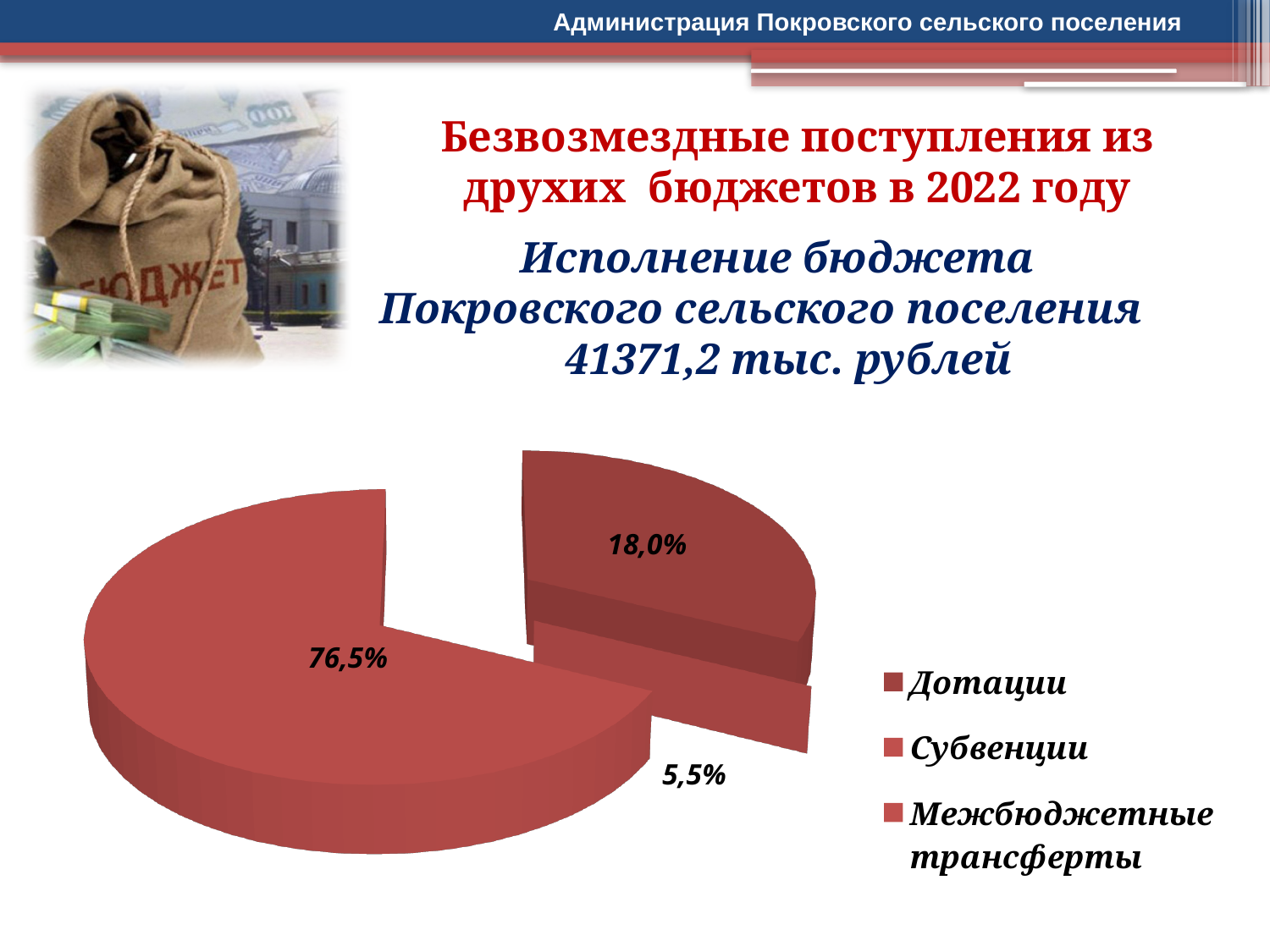
What is the difference between the largest slice (76,5%) and the 18,0% slice? 58,5% What total amount of budget execution is stated in the slide heading above the chart? 41371,2 тыс. рублей What are the three legend entries of the pie chart? Дотации, Субвенции, Межбюджетные трансферты What is the difference between the 18,0% slice and the 5,5% slice? 12,5% What is the value of the largest slice of the pie chart? 76,5% Which is larger: the slice labelled 18,0% or the slice labelled 5,5%? 18,0% What is the value of the exploded slice at the top right of the pie chart? 18,0% How many entries does the legend of the pie chart list? 3 What is the value of the smallest slice of the pie chart? 5,5% Is the largest slice of the pie chart greater or less than 50%? greater What kind of chart is shown on the slide? pie chart How many slices does the pie chart have? 3